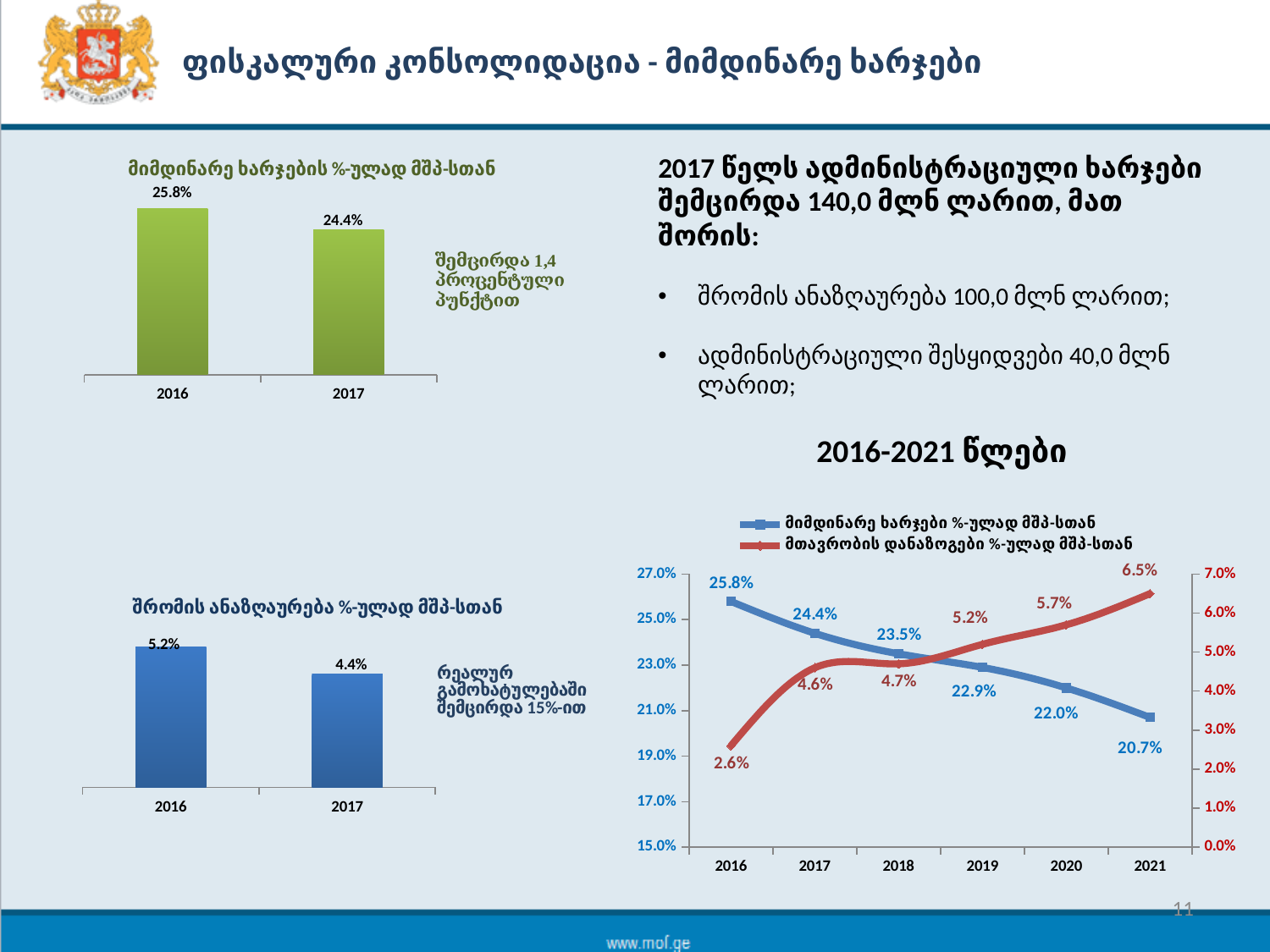
In the right-hand line chart (2016-2021 წლები), does მიმდინარე ხარჯები %-ულად მშპ-სთან rise or fall from 2016 to 2021? Fall In the bottom-left bar chart (შრომის ანაზღაურება %-ულად მშპ-სთან), which year has the higher value? 2016 What type of chart is the bottom-left chart (შრომის ანაზღაურება %-ულად მშპ-სთან)? Bar chart In the right-hand line chart (2016-2021 წლები), how many series does the legend list? 2 In the bottom-left bar chart (შრომის ანაზღაურება %-ულად მშპ-სთან), what is the value for 2017? 4.4% In the right-hand line chart (2016-2021 წლები), what is the value of მთავრობის დანაზოგები %-ულად მშპ-სთან in 2021? 6.5% In the right-hand line chart (2016-2021 წლები), what is the value of მიმდინარე ხარჯები %-ულად მშპ-სთან in 2019? 22.9% In the top-left bar chart (მიმდინარე ხარჯების %-ულად მშპ-სთან), what is the value for 2017? 24.4% In the top-left bar chart, what is the difference between the 2016 and 2017 values? 1.4 percentage points In the right-hand line chart (2016-2021 წლები), in which year is მთავრობის დანაზოგები %-ულად მშპ-სთან lowest? 2016 In the top-left bar chart (მიმდინარე ხარჯების %-ულად მშპ-სთან), what is the value for 2016? 25.8% In the right-hand line chart (2016-2021 წლები), how many years are shown on the x axis? 6